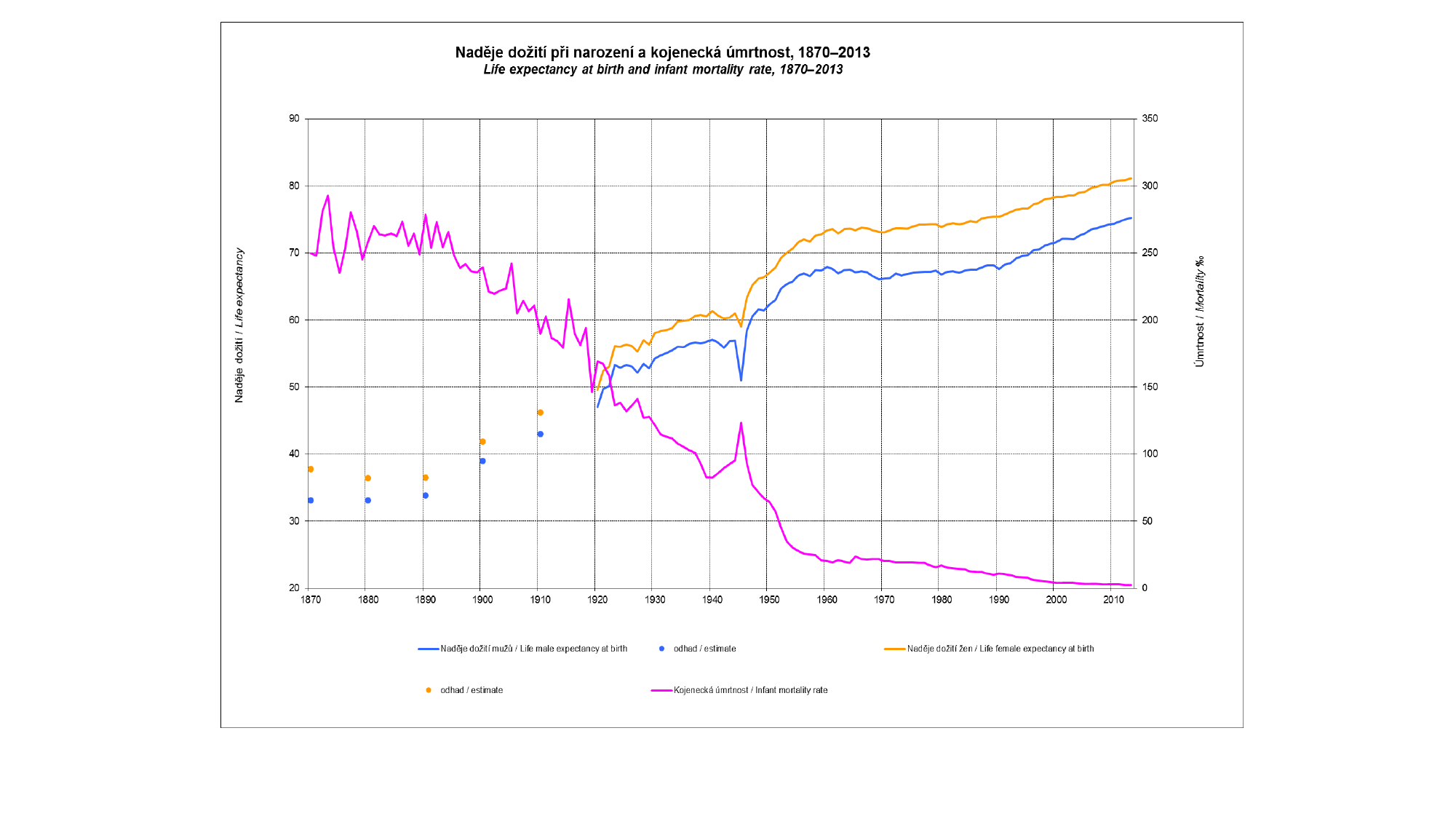
Which is higher, the infant mortality rate in 1870 or in 2010? 1870 How many series does the legend list? 5 Is the male life expectancy at birth in 1920 greater or less than 50? less Is the infant mortality rate in 1870 greater or less than 200‰? greater What colour is the line for Kojenecká úmrtnost / Infant mortality rate? magenta Which is higher in 2010, the female or the male life expectancy at birth? female Is the female life expectancy at birth in 2000 greater or less than 70? greater What is the title of the chart in English? Life expectancy at birth and infant mortality rate, 1870–2013 Does the female life expectancy at birth rise or fall overall from 1920 to 2013? rise What kind of chart is shown on the slide? line chart Does the infant mortality rate rise or fall overall from 1870 to 2013? fall